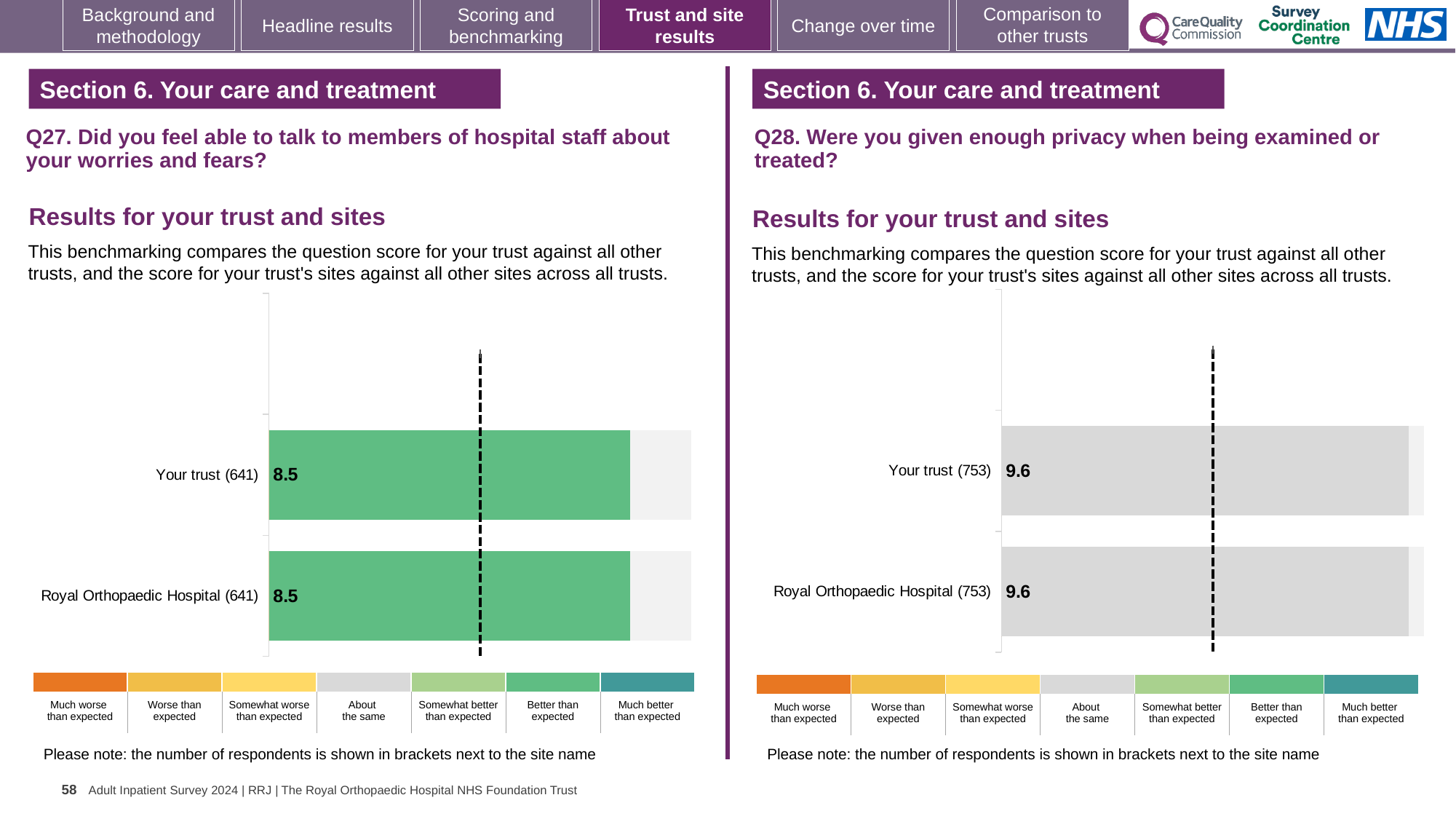
On the Q28 chart (right), what is the score for Royal Orthopaedic Hospital (753)? 9.6 How many bars are plotted on the Q27 chart (left)? 2 How many bars are plotted on the Q28 chart (right)? 2 On the Q27 chart (left), what is the score for Your trust (641)? 8.5 On the Q27 chart (left), what is the difference between the score for Your trust and the score for Royal Orthopaedic Hospital? 0 What kind of chart is used on the Q27 chart (left)? Bar chart On the Q28 chart (right), which benchmark category does the grey colour of the bars correspond to in the key? About the same On the Q28 chart (right), what is the difference between the score for Your trust and the score for Royal Orthopaedic Hospital? 0 How many respondents are shown in brackets for Your trust on the Q28 chart (right)? 753 On the Q27 chart (left), which benchmark category does the green colour of the bars correspond to in the key? Better than expected On the Q27 chart (left), what is the score for Royal Orthopaedic Hospital (641)? 8.5 On the Q28 chart (right), what is the score for Your trust (753)? 9.6